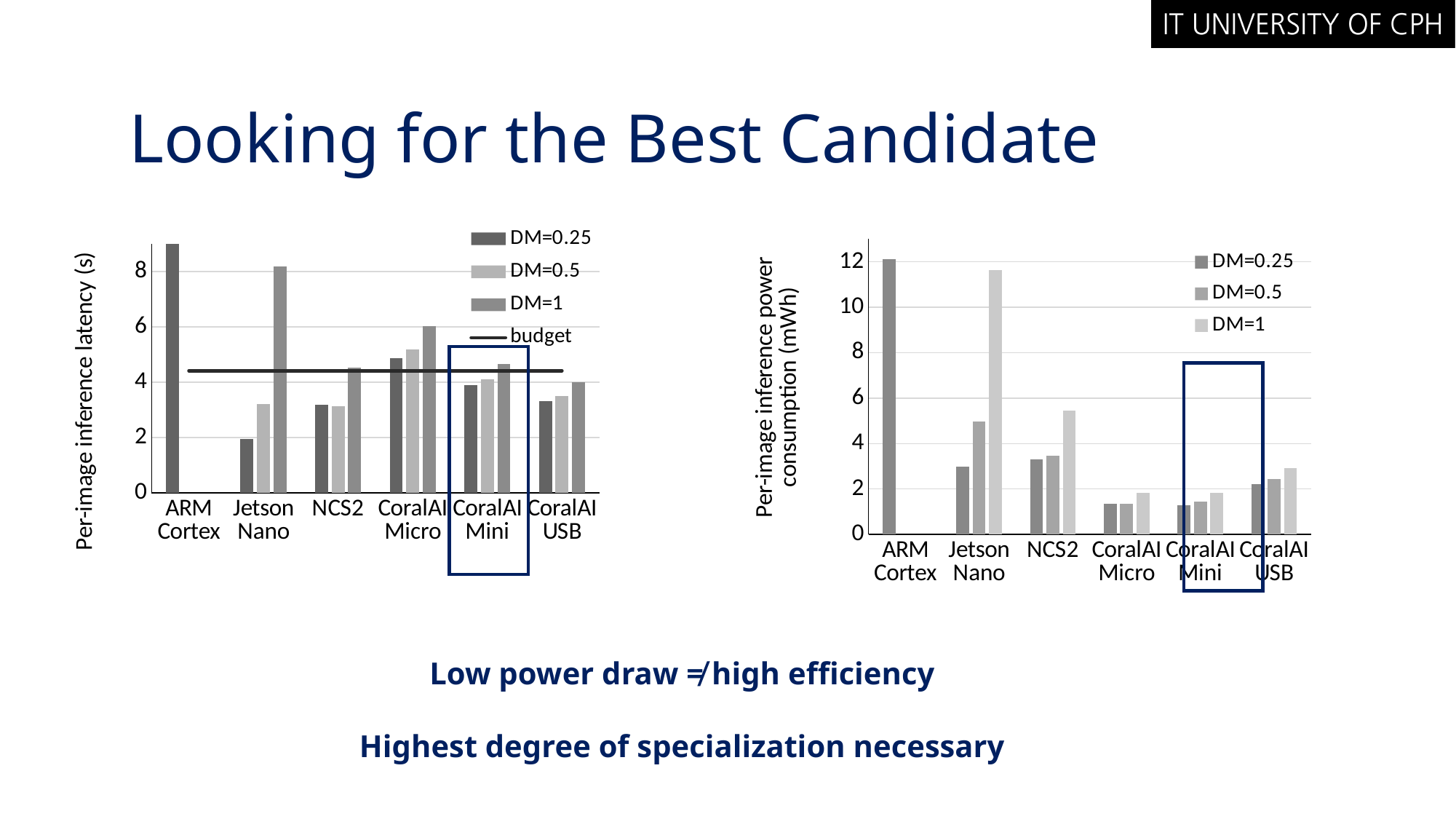
In the right chart (per-image inference power consumption), which device has the highest DM=1 bar? Jetson Nano What is the y-axis label of the right chart? Per-image inference power consumption (mWh) How many entries does the legend of the left chart (per-image inference latency) list? 4 In the left chart (per-image inference latency), is the DM=1 value for Jetson Nano greater or less than 6? greater In the left chart (per-image inference latency), which device has the highest DM=0.25 bar? ARM Cortex In the right chart (per-image inference power consumption), is the DM=0.25 value for ARM Cortex greater or less than 10? greater In the left chart (per-image inference latency), which is larger for CoralAI Micro: the DM=0.25 bar or the DM=1 bar? DM=1 In the right chart (per-image inference power consumption), is the DM=1 value for CoralAI Micro greater or less than 4? less What kind of chart is the left chart (per-image inference latency)? bar chart How many device categories are shown on the x axis of the right chart (per-image inference power consumption)? 6 In the right chart (per-image inference power consumption), which device has a larger DM=0.5 value: Jetson Nano or NCS2? Jetson Nano How many series does the legend of the right chart (per-image inference power consumption) list? 3